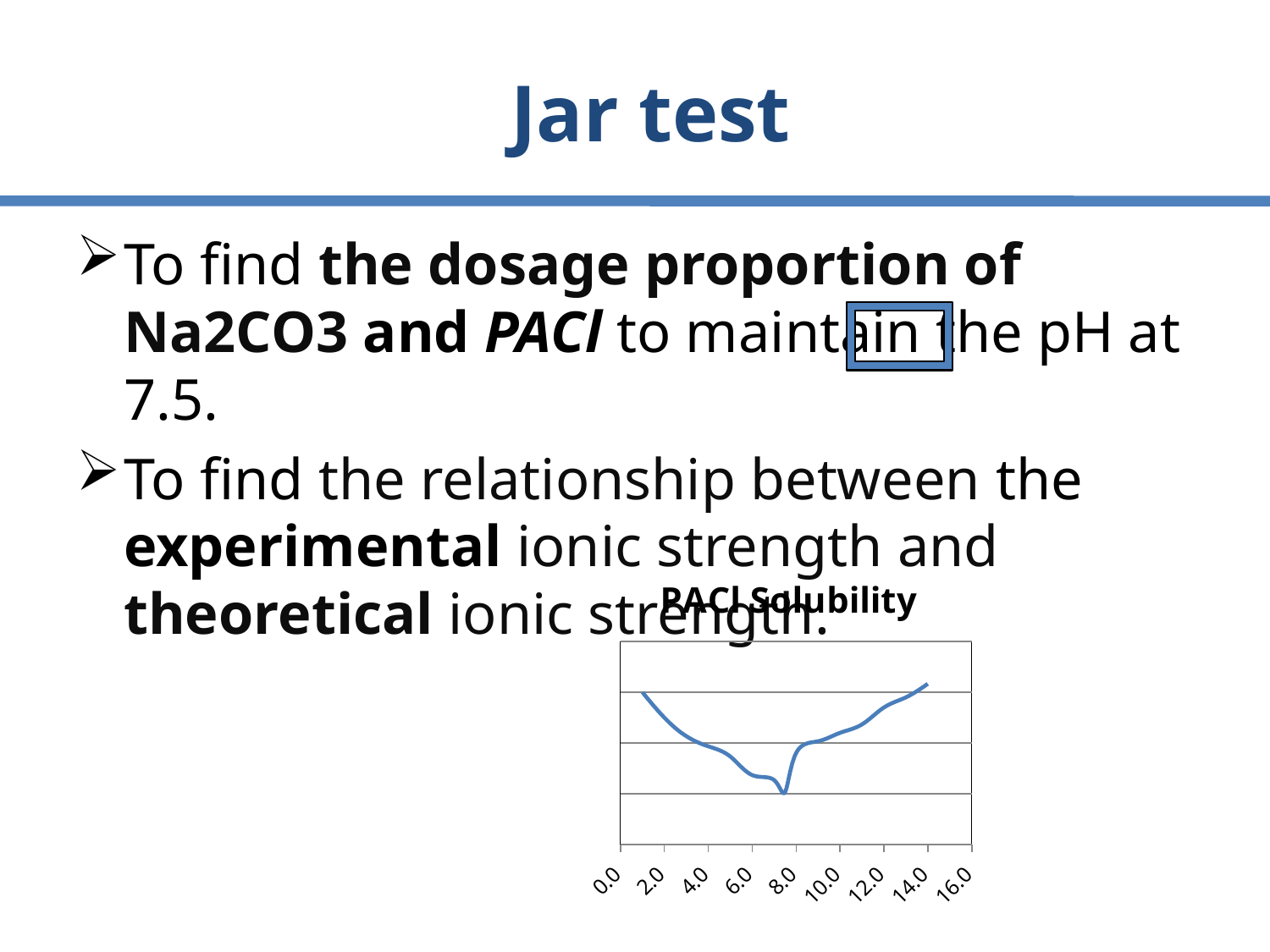
How many tick labels are shown on the x axis of the PACl Solubility chart? 9 What kind of chart is shown on the slide? line chart In the PACl Solubility chart, is the value at x = 14.0 higher or lower than the value at x = 6.0? higher In the PACl Solubility chart, does the line rise or fall between 2.0 and 6.0 on the x axis? fall In the PACl Solubility chart, is the value at x = 2.0 higher or lower than the value at x = 8.0? higher What is the title of the chart on the slide? PACl Solubility In the PACl Solubility chart, does the line reach its lowest point before or after x = 10.0? before What is the largest value labelled on the x axis of the PACl Solubility chart? 16.0 In the PACl Solubility chart, does the line rise or fall between 10.0 and 14.0 on the x axis? rise